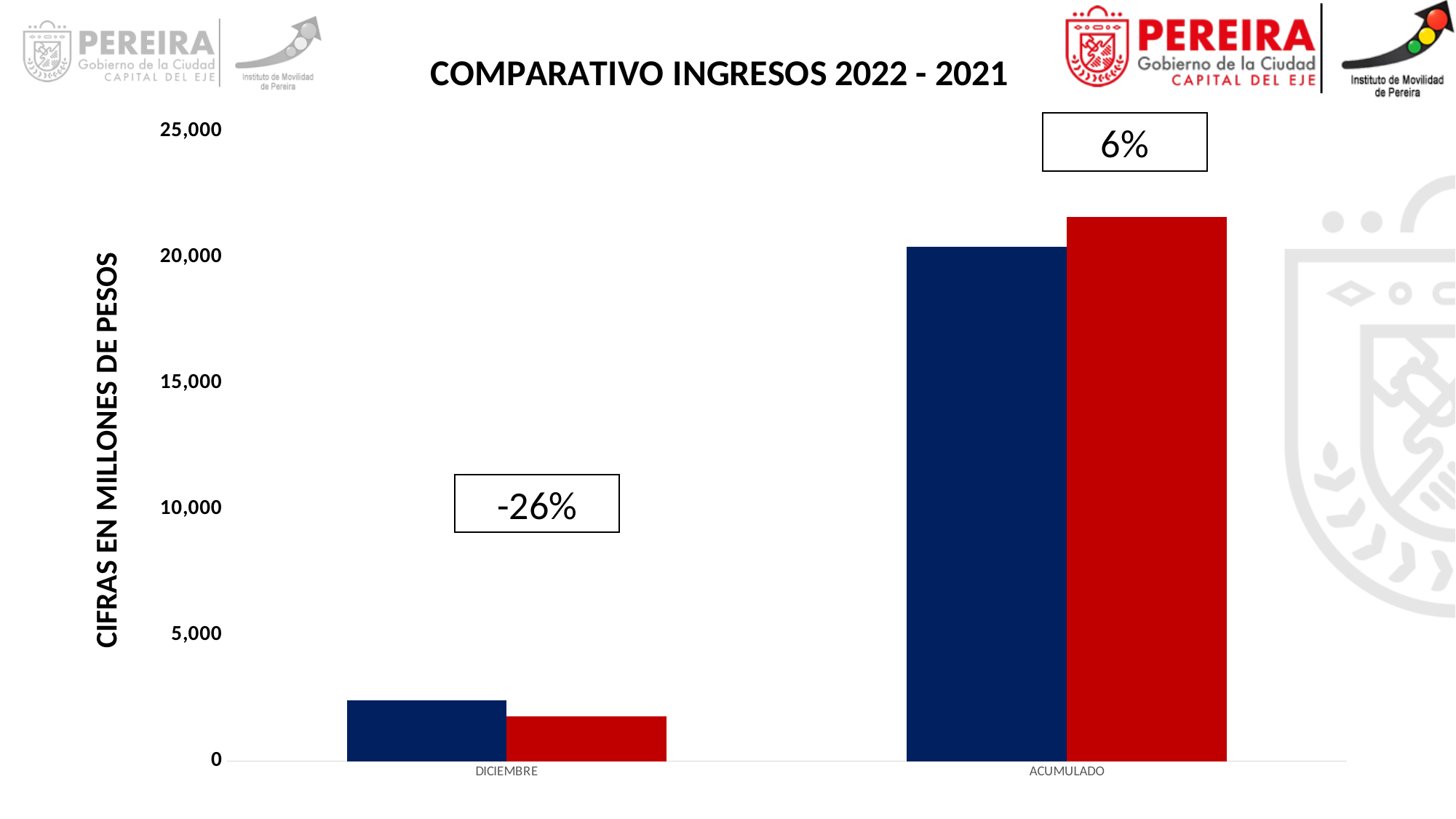
What is the label on the vertical axis of the chart? CIFRAS EN MILLONES DE PESOS Which category has the tallest bar in the chart? ACUMULADO What kind of chart is shown on the slide? bar chart How many categories are shown on the x axis of the chart? 2 For DICIEMBRE, which bar is taller, the dark blue bar or the red bar? the dark blue bar What percentage is shown in the box above the ACUMULADO bars? 6% Is the value of the dark blue bar for DICIEMBRE greater or less than 5,000? less Which category has the shortest bar in the chart? DICIEMBRE What percentage is shown in the box above the DICIEMBRE bars? -26% Is the value of the red bar for ACUMULADO greater or less than 20,000? greater What is the title of the chart? COMPARATIVO INGRESOS 2022 - 2021 For ACUMULADO, which bar is taller, the dark blue bar or the red bar? the red bar